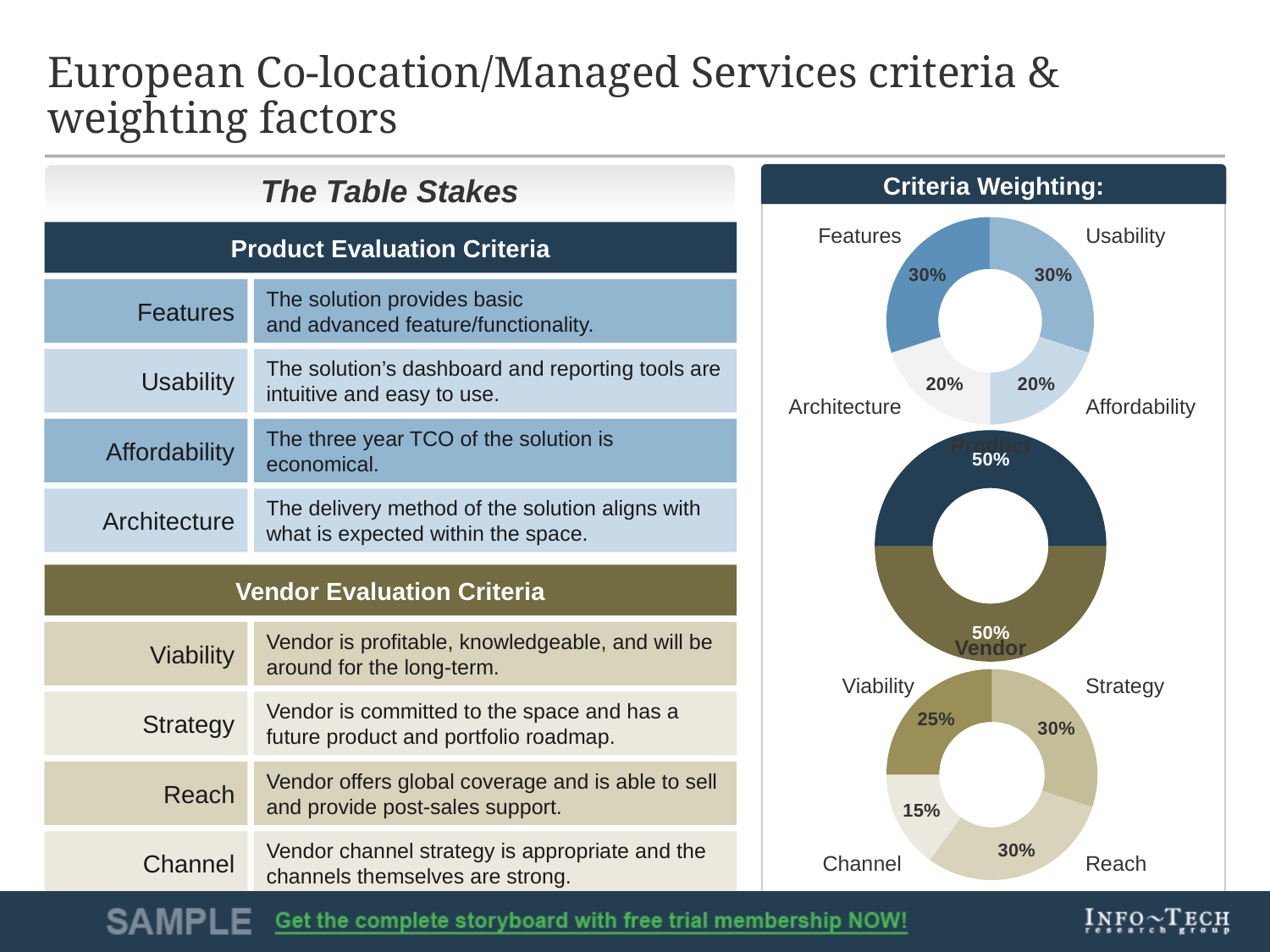
In the top donut chart under Criteria Weighting, what is the weighting for Architecture? 20% In the top donut chart under Criteria Weighting, which is larger, the weighting for Usability or for Affordability? Usability In the top donut chart under Criteria Weighting, what is the weighting for Features? 30% In the top donut chart under Criteria Weighting, what is the combined weighting of Features and Usability? 60% How many slices does the top donut chart under Criteria Weighting have? 4 In the middle donut chart under Criteria Weighting, what share is given to Vendor? 50% In the bottom donut chart under Criteria Weighting, what is the difference between the weightings for Strategy and Channel? 15% In the bottom donut chart under Criteria Weighting, what is the weighting for Viability? 25% How many slices does the middle donut chart under Criteria Weighting have? 2 In the bottom donut chart under Criteria Weighting, which criterion has the lowest weighting? Channel What type of chart is used for the Criteria Weighting section? Donut (pie) chart In the bottom donut chart under Criteria Weighting, what is the weighting for Channel? 15%